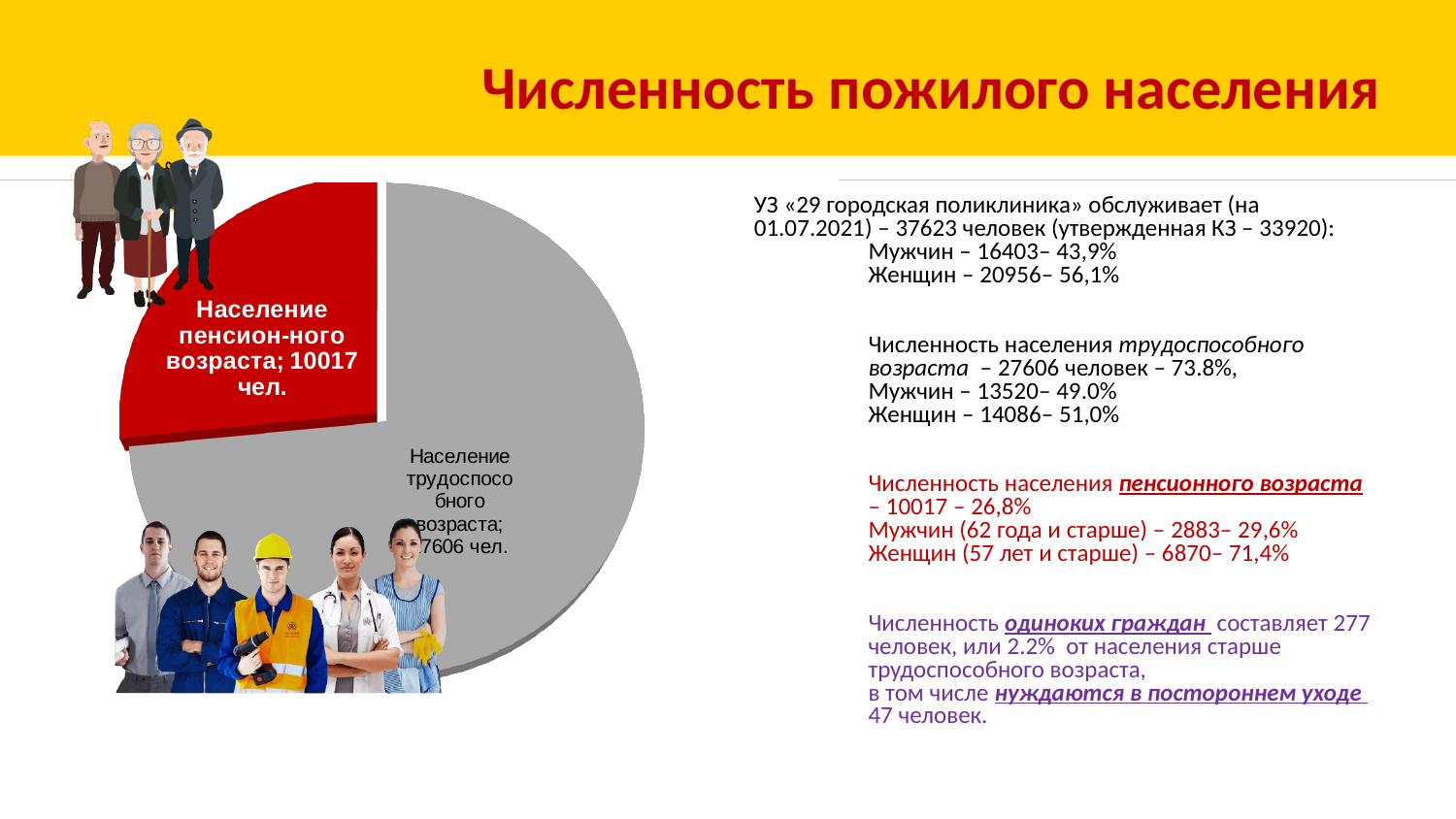
What is the title of the slide containing the pie chart? Численность пожилого населения What value is shown for the slice 'Население пенсионного возраста'? 10017 чел. Which slice of the pie chart is the smallest? Население пенсионного возраста What value is shown for the slice 'Население трудоспособного возраста'? 27606 чел. Which is larger: the population of working age or the population of pension age? Население трудоспособного возраста What kind of chart is shown on the slide? pie chart How many slices does the pie chart have? 2 What colour is the slice for 'Население пенсионного возраста'? red Which slice of the pie chart is the largest? Население трудоспособного возраста What is the difference between the working-age population and the pension-age population shown in the chart? 17589 What is the total of the two slices in the pie chart? 37623